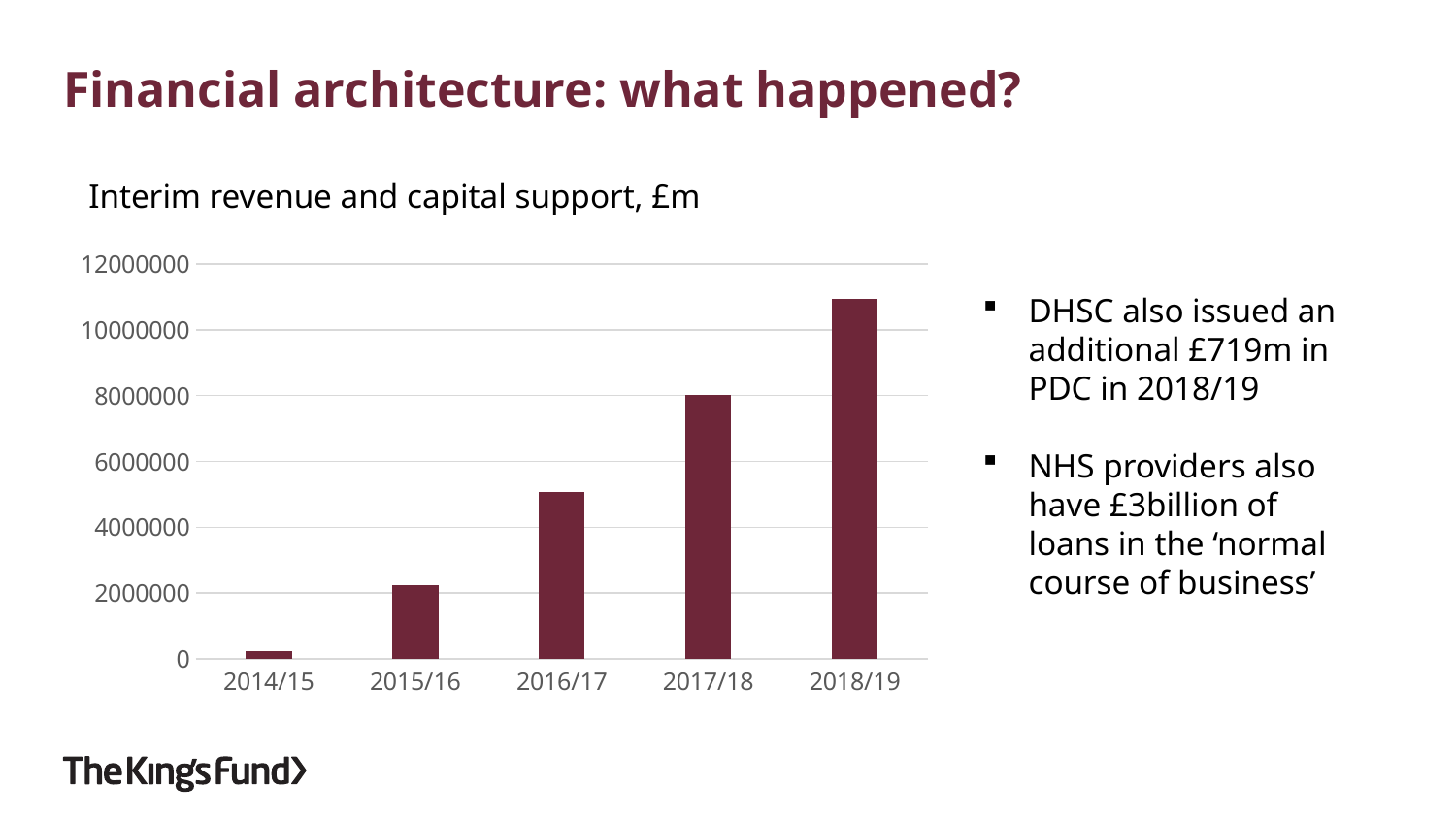
Is the value for 2014/15 greater or less than 2000000? less Is the value for 2018/19 greater or less than 10000000? greater Is the value for 2015/16 greater or less than 4000000? less How many financial years are shown on the x axis of the chart? 5 What is the highest value shown on the y axis of the chart? 12000000 Which year has the highest value in the chart? 2018/19 What is the title of the chart? Interim revenue and capital support, £m What kind of chart is shown on the slide? bar chart Do the values rise or fall from 2014/15 to 2018/19? rise Which is larger, the value for 2017/18 or the value for 2016/17? 2017/18 Which year has the lowest value in the chart? 2014/15